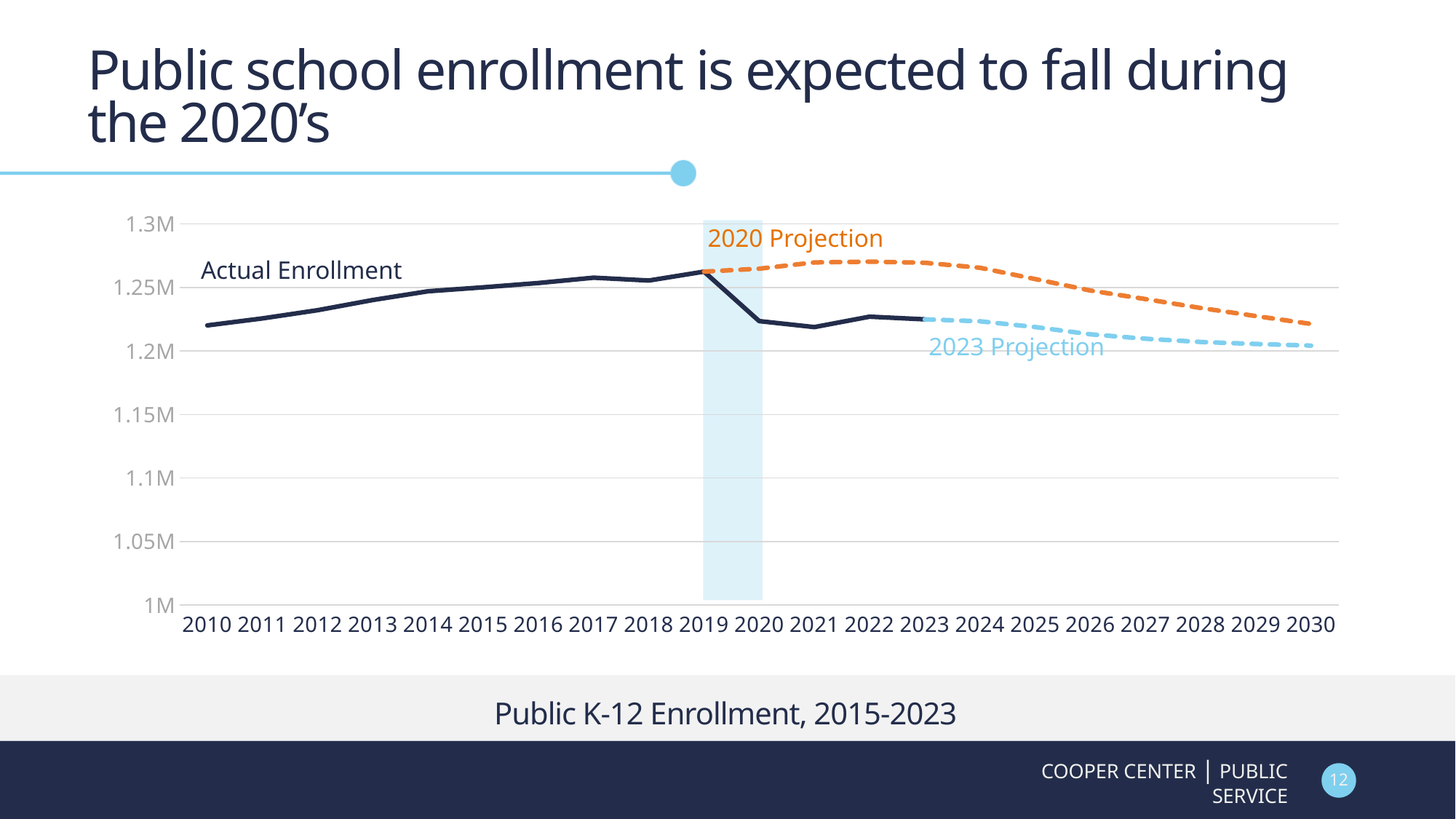
Is the Actual Enrollment value for 2010 greater or less than 1.25M? less What type of chart is shown on the slide? Line chart Is the 2023 Projection value for 2030 greater or less than 1.25M? less Is the 2020 Projection value for 2030 greater or less than 1.2M? greater How many series are labelled on the chart? 3 Does the Actual Enrollment line rise or fall from 2010 to 2019? rise In 2030, which is higher: the 2020 Projection or the 2023 Projection? 2020 Projection What is the caption below the chart? Public K-12 Enrollment, 2015-2023 How many years are shown on the x axis of the chart? 21 What colour is the 2020 Projection line? Orange Does the 2020 Projection line rise or fall from 2024 to 2030? fall